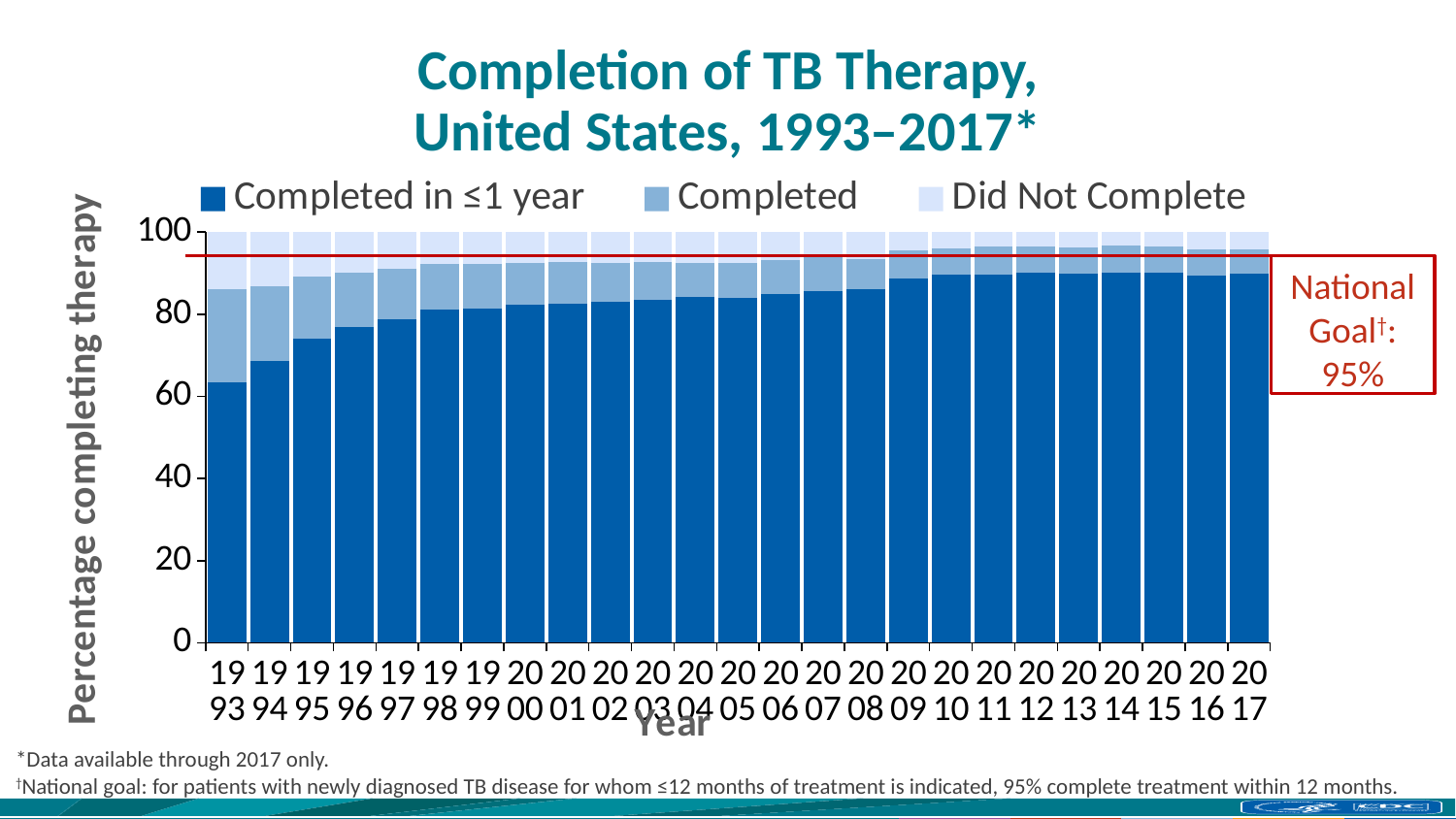
Which is larger for Completed in ≤1 year: 1993 or 2017? 2017 How many years (bars) are plotted on the chart? 25 Is the value for Completed in ≤1 year in 2017 greater or less than 80? greater Which year has the lowest value for Completed in ≤1 year? 1993 Does the Completed in ≤1 year series generally rise or fall from 1993 to 2017? Rise Is the value for Completed in ≤1 year in 1993 greater or less than 80? less What kind of chart is shown on the slide? Stacked bar chart Is the value for Completed in ≤1 year in 1994 greater or less than 80? less How many series does the legend list? 3 What national goal percentage is marked on the chart? 95% What is the title of the chart? Completion of TB Therapy, United States, 1993–2017*